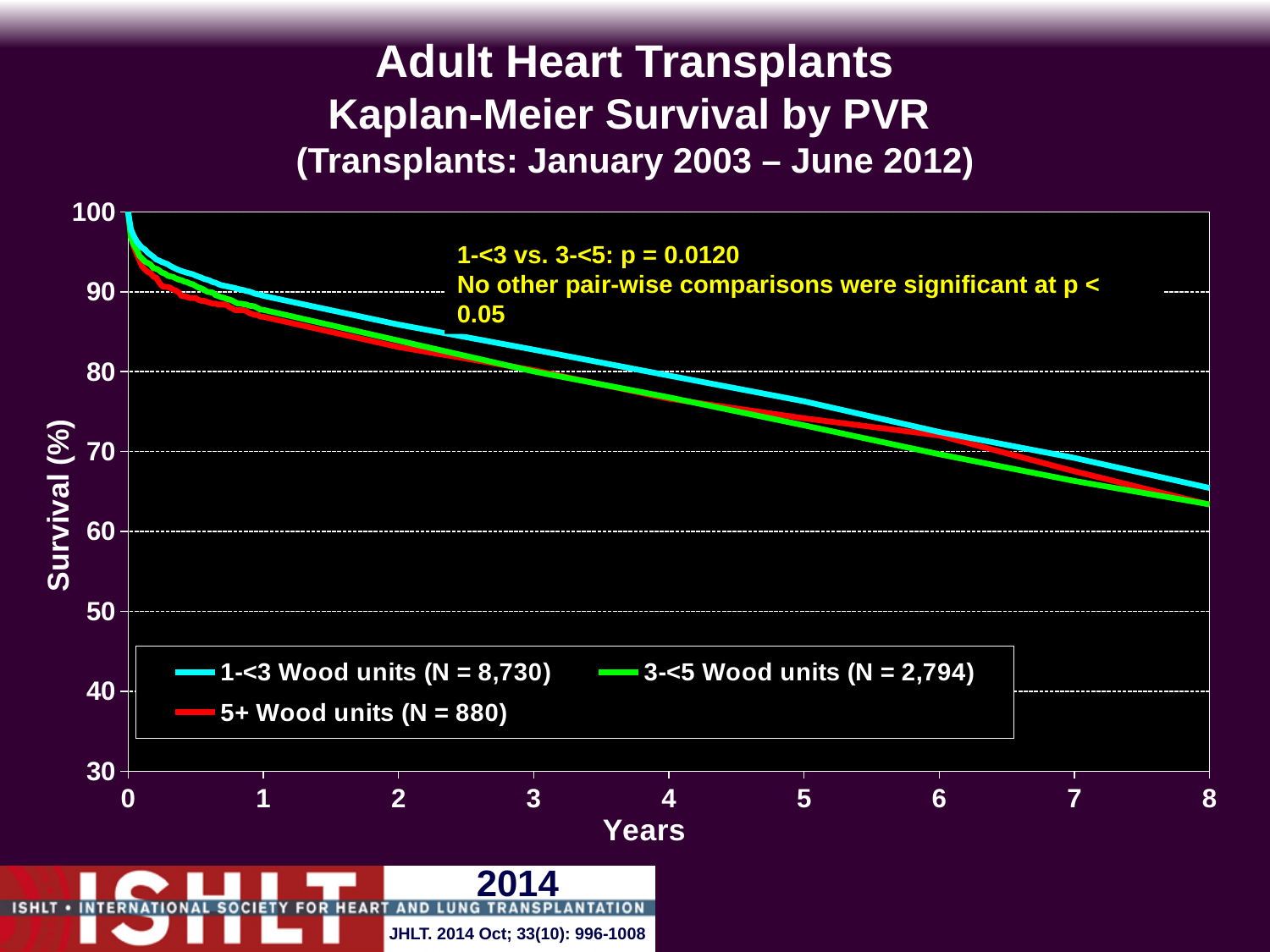
At 2 years, which group has higher survival: 1-<3 Wood units or 3-<5 Wood units? 1-<3 Wood units Is the survival for 3-<5 Wood units at 2 years greater or less than 90? less Do the survival curves rise or fall as years increase? fall Is the survival for 1-<3 Wood units at 8 years greater or less than 60? greater How many series does the legend list? 3 Is the survival for 1-<3 Wood units at 2 years greater or less than 80? greater What is the N for the 1-<3 Wood units group shown in the legend? 8,730 Which group has the lowest survival at around 0.5 years? 5+ Wood units Which group has the highest survival at 8 years? 1-<3 Wood units What p-value is given for the 1-<3 vs. 3-<5 comparison? p = 0.0120 What kind of chart is shown on the slide? line chart